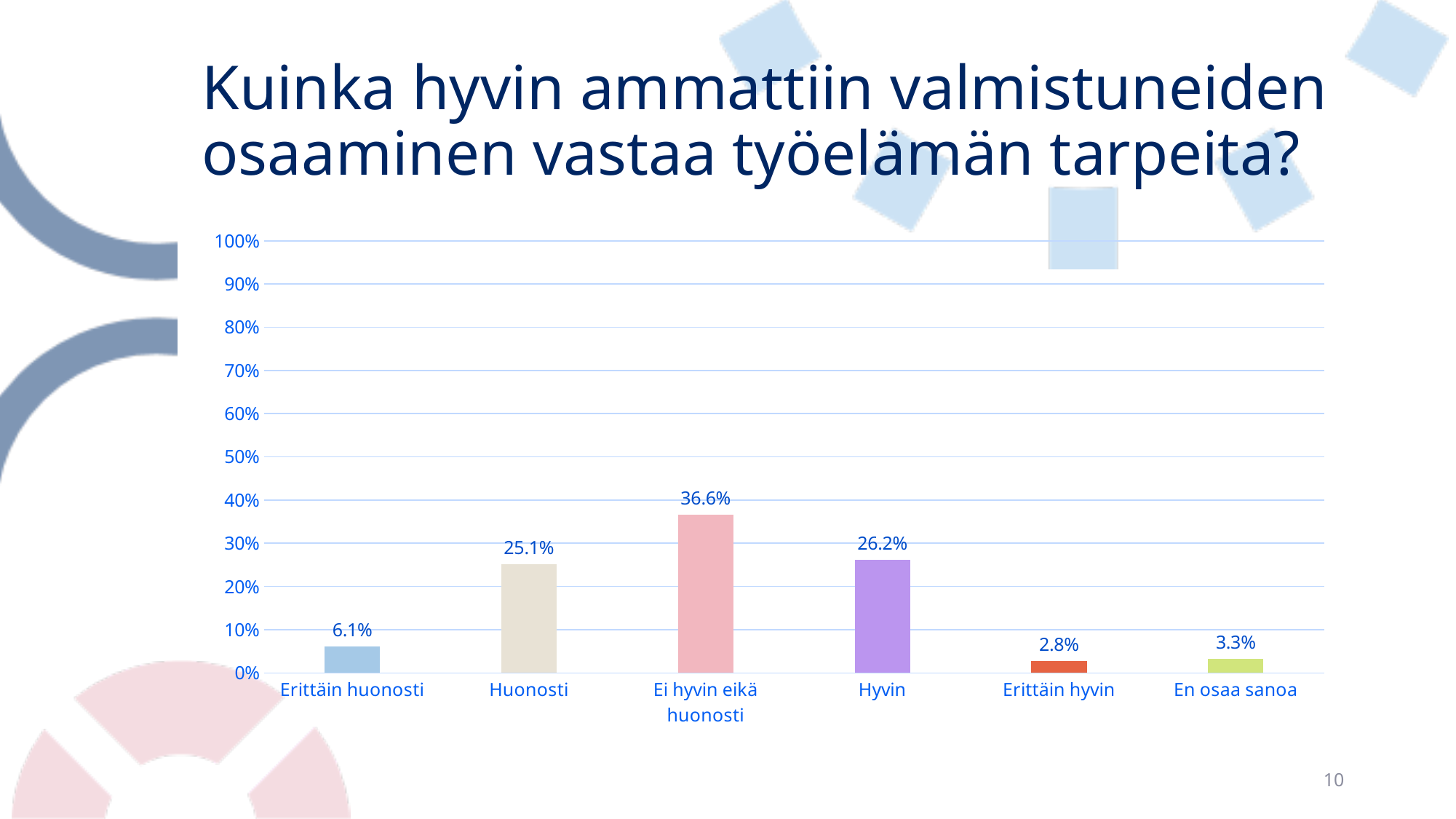
Which is larger, the value for Hyvin or the value for Huonosti? Hyvin What is the value for En osaa sanoa? 3.3% What is the value for Ei hyvin eikä huonosti? 36.6% Which category has the highest value? Ei hyvin eikä huonosti What is the value for Erittäin huonosti? 6.1% What is the difference between the values for Ei hyvin eikä huonosti and Erittäin huonosti? 30.5% What is the difference between the values for Hyvin and Huonosti? 1.1% Is the value for Ei hyvin eikä huonosti greater or less than 40%? less How many categories are shown on the x axis? 6 What is the title of the slide? Kuinka hyvin ammattiin valmistuneiden osaaminen vastaa työelämän tarpeita? What kind of chart is shown on the slide? bar chart Which category has the lowest value? Erittäin hyvin